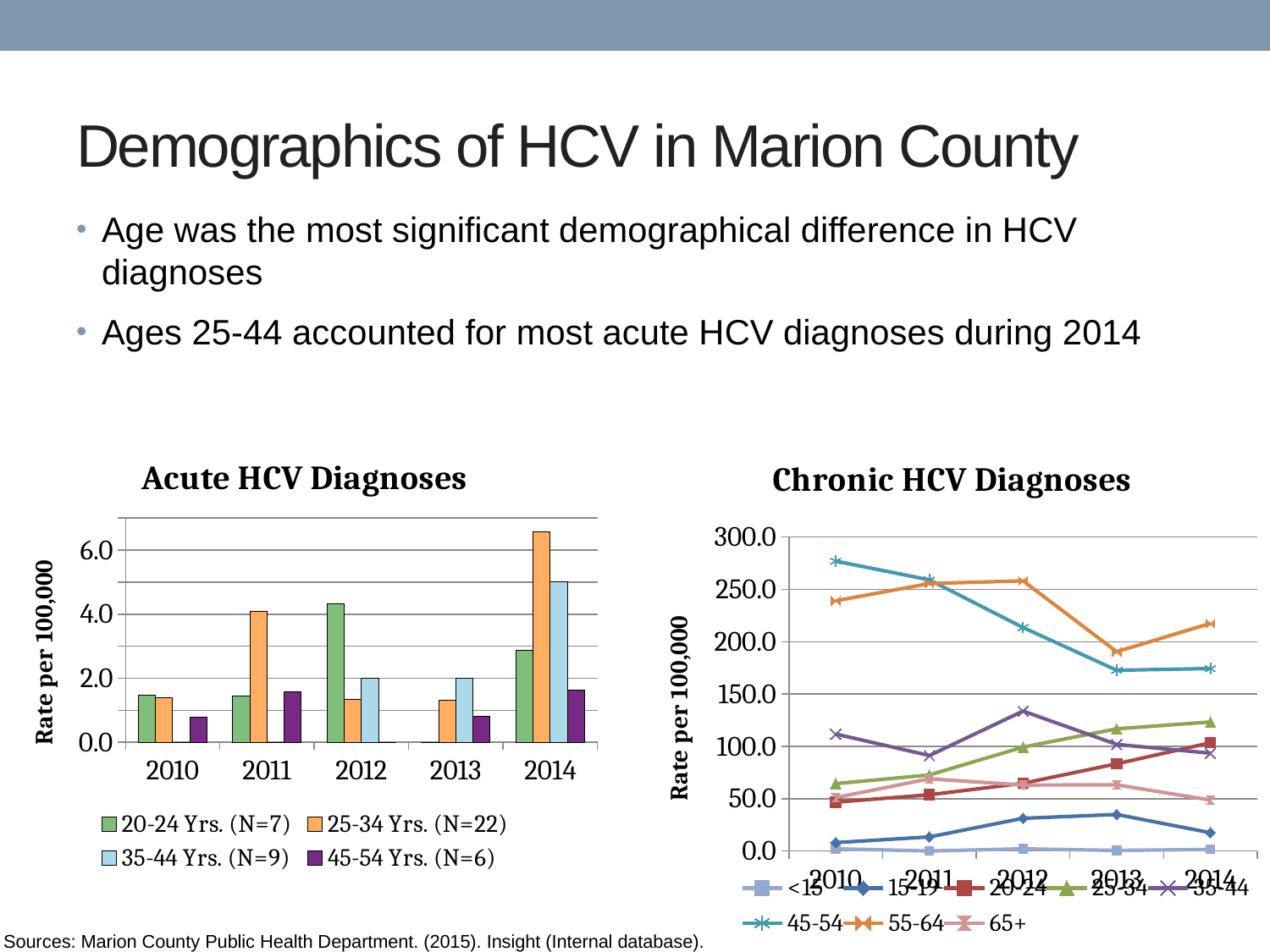
In the Chronic HCV Diagnoses chart, is the value for 45-54 in 2010 greater or less than 250.0? greater What kind of chart is the Chronic HCV Diagnoses chart? line chart How many years are shown on the x axis of the Acute HCV Diagnoses chart? 5 In the Acute HCV Diagnoses chart, which age group has the highest bar in 2014? 25-34 Yrs. (N=22) How many series does the legend of the Chronic HCV Diagnoses chart list? 8 In the Acute HCV Diagnoses chart, is the value for 25-34 Yrs. in 2014 greater or less than 6.0? greater In the Chronic HCV Diagnoses chart, does the 45-54 line rise or fall from 2010 to 2014? fall In the Acute HCV Diagnoses chart, which year has the highest bar for 25-34 Yrs.? 2014 In the Chronic HCV Diagnoses chart, which age group has the highest value in 2014? 55-64 How many series does the legend of the Acute HCV Diagnoses chart list? 4 In the Acute HCV Diagnoses chart, is the value for 20-24 Yrs. in 2010 greater or less than 2.0? less What kind of chart is the Acute HCV Diagnoses chart? bar chart